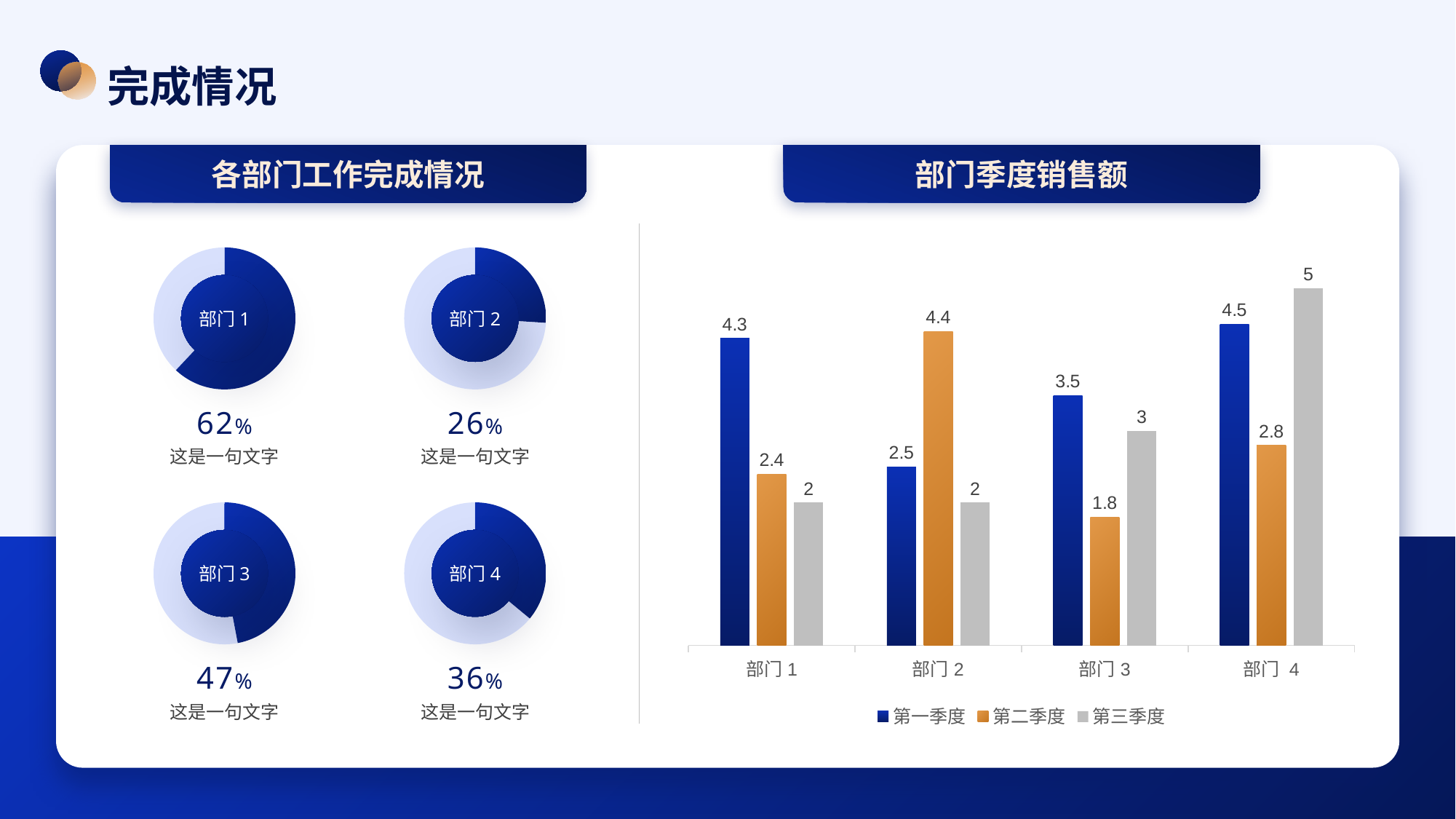
How many series does the legend of the 部门季度销售额 chart list? 3 In the 部门季度销售额 chart, what is the 第二季度 value for 部门 2? 4.4 In the 部门季度销售额 chart, what is the 第三季度 value for 部门 4? 5 In the 各部门工作完成情况 section, which department has the lowest completion percentage? 部门 2 In the 部门季度销售额 chart, what is the difference between the 第三季度 value for 部门 4 and the 第三季度 value for 部门 3? 2 In the 各部门工作完成情况 section, what is the completion percentage shown for 部门 3? 47% What kind of chart is the 部门季度销售额 chart? Bar chart In the 部门季度销售额 chart, what is the 第一季度 value for 部门 1? 4.3 How many departments are shown on the x axis of the 部门季度销售额 chart? 4 In the 部门季度销售额 chart, which department has the highest 第一季度 value? 部门 4 In the 部门季度销售额 chart, which department has the lowest 第二季度 value? 部门 3 In the 部门季度销售额 chart, which is larger for 部门 2: the 第一季度 value or the 第二季度 value? 第二季度